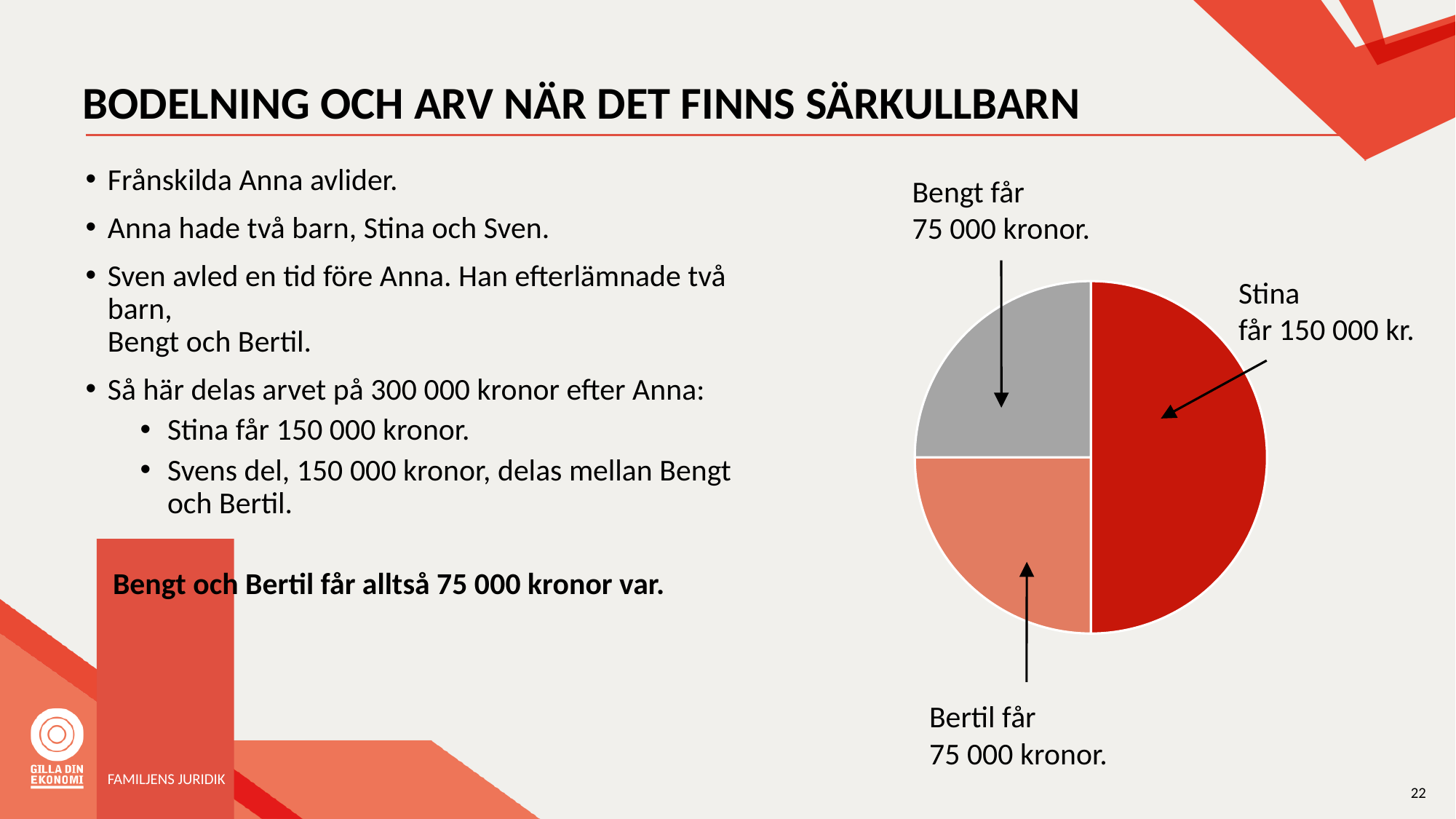
What is the difference between Stina's amount and Bengt's amount in the pie chart? 75 000 kronor How much does Stina get according to the pie chart? 150 000 kr What kind of chart is shown on the slide? pie chart What is the total amount represented by the whole pie chart? 300 000 kronor Who receives the largest share of the inheritance in the pie chart? Stina What share of the pie does Bengt's slice represent? 25% What share of the pie does Stina's slice represent? 50% What colour is the slice representing Bengt in the pie chart? grey How much does Bengt get according to the pie chart? 75 000 kronor Which is larger in the pie chart, Stina's share or Bertil's share? Stina's share How many slices does the pie chart have? 3 How much does Bertil get according to the pie chart? 75 000 kronor